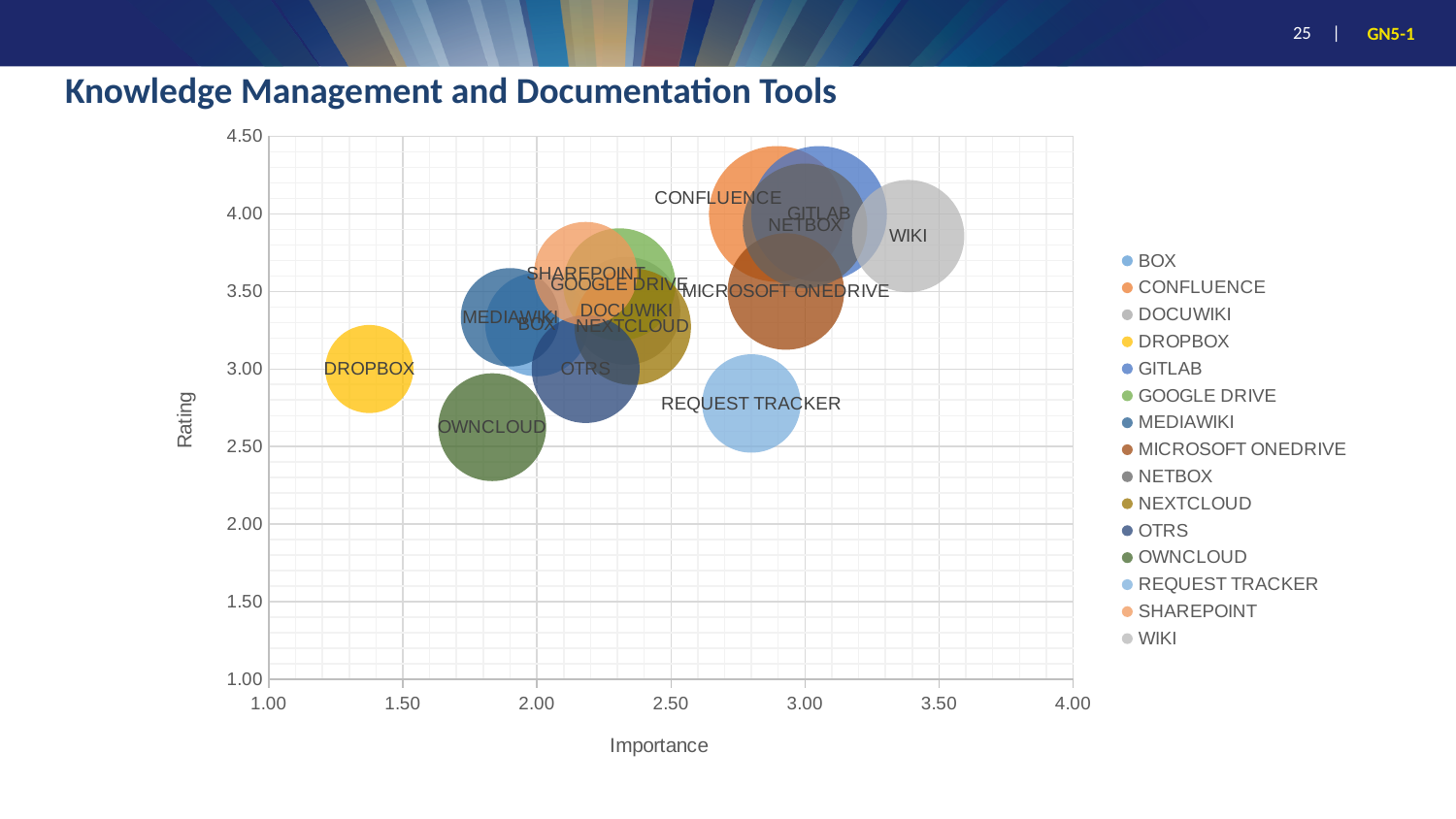
Which has the higher Rating, REQUEST TRACKER or CONFLUENCE? CONFLUENCE Is the Importance value for DROPBOX greater or less than 1.50? less How many tools does the legend list? 15 Which tool has the lowest Importance value? DROPBOX Is the Rating value for OWNCLOUD greater or less than 3.00? less What is the label of the horizontal axis? Importance Is the Rating value for CONFLUENCE greater or less than 3.50? greater What is the label of the vertical axis? Rating What kind of chart is shown on the slide? Bubble chart Which tool has the highest Importance value? WIKI Which has the higher Importance, DROPBOX or WIKI? WIKI